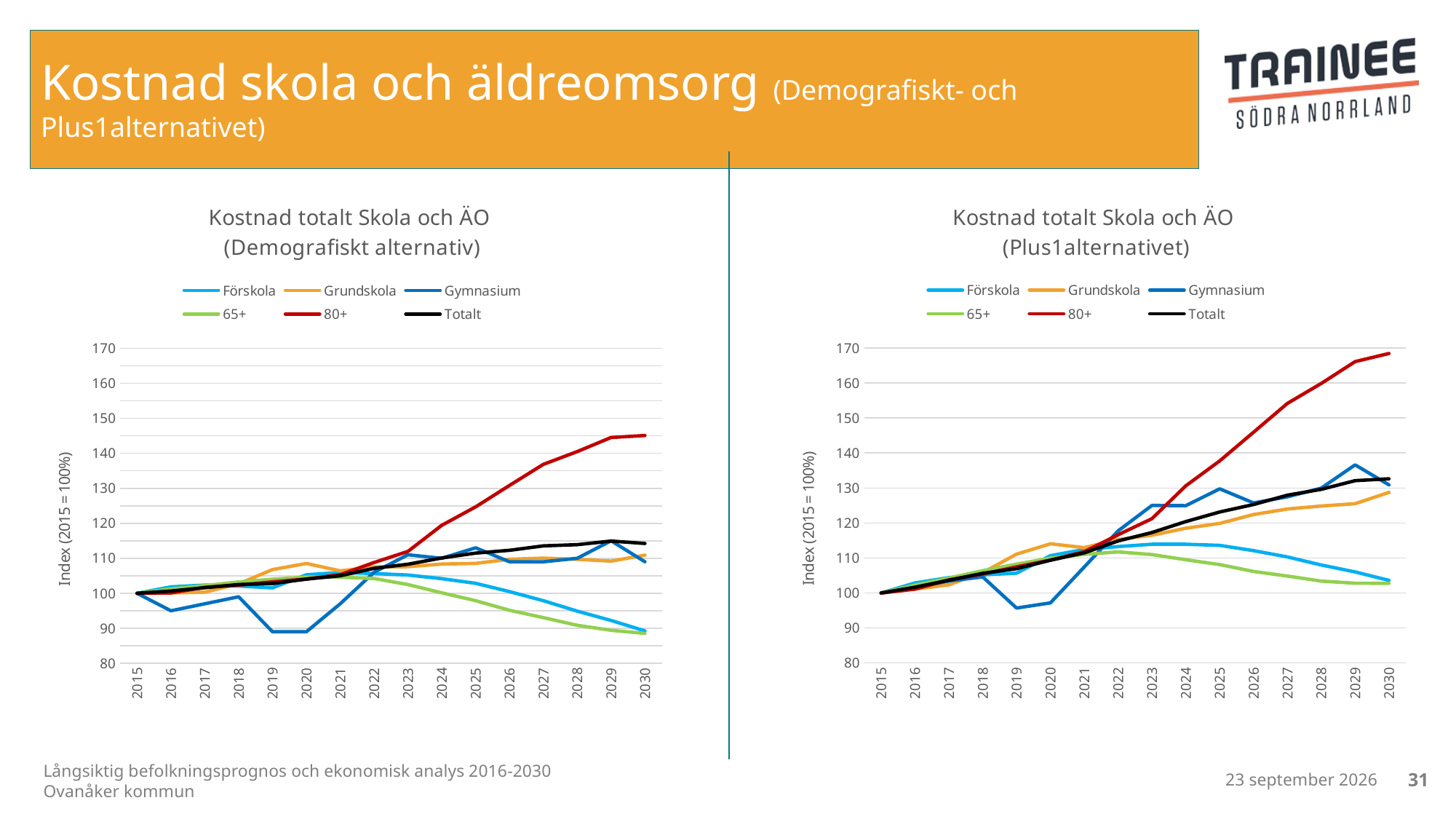
What is the y-axis label of the right chart (Plus1alternativet)? Index (2015 = 100%) How many years are shown on the x axis of the left chart (Demografiskt alternativ)? 16 In the right chart (Plus1alternativet), which series has the highest value in 2030? 80+ In the left chart (Demografiskt alternativ), which series has the highest value in 2030? 80+ How many series does the legend of the right chart, 'Kostnad totalt Skola och ÄO (Plus1alternativet)', list? 6 In the left chart (Demografiskt alternativ), is the value for 80+ in 2030 greater or less than 140? greater What kind of chart is the left chart, 'Kostnad totalt Skola och ÄO (Demografiskt alternativ)'? Line chart In the right chart (Plus1alternativet), is the value for Totalt in 2030 greater or less than 130? greater In the right chart (Plus1alternativet), is the value for 80+ in 2030 greater or less than 160? greater In the left chart (Demografiskt alternativ), which is larger in 2019: Förskola or Gymnasium? Förskola In the left chart (Demografiskt alternativ), does the 80+ series rise or fall from 2015 to 2030? Rises